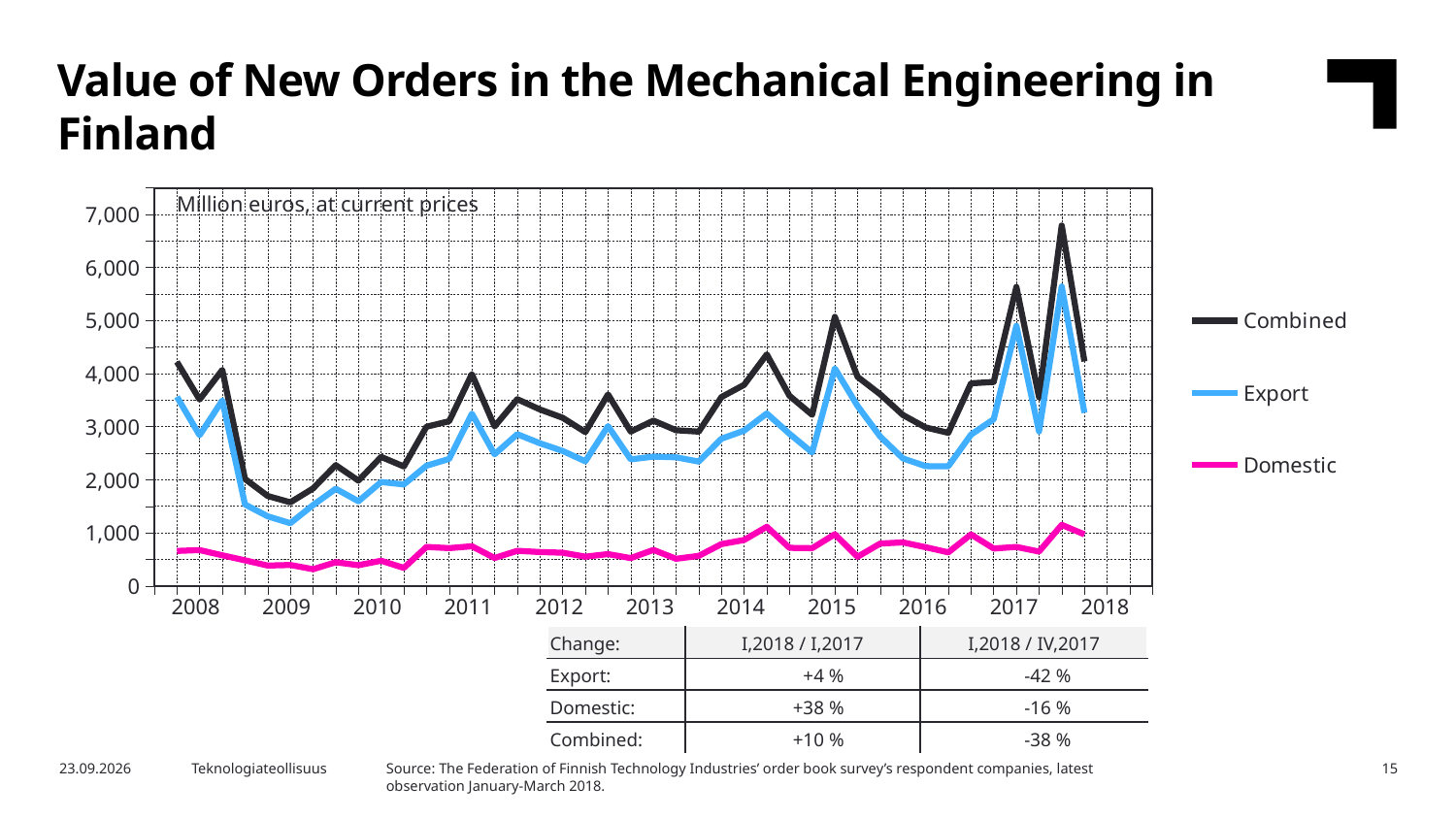
Does the Combined series rise or fall from the start of 2008 to the start of 2009? fall What unit is stated at the top of the chart? Million euros, at current prices Which series is plotted with the pink line? Domestic Is the value of the Export series at the start of 2009 greater or less than 2,000? less Is the peak value of the Combined series in 2017 greater or less than 6,000? greater What kind of chart is shown on the slide? Line chart Which series has the lowest values throughout the chart? Domestic How many series does the chart's legend list? 3 Which series has the highest values throughout the chart? Combined Is the value of the Domestic series in 2008 greater or less than 1,000? less According to the change table below the chart, what is the Domestic change for I,2018 / I,2017? +38 % In 2014, which is larger, the Export value or the Domestic value? Export